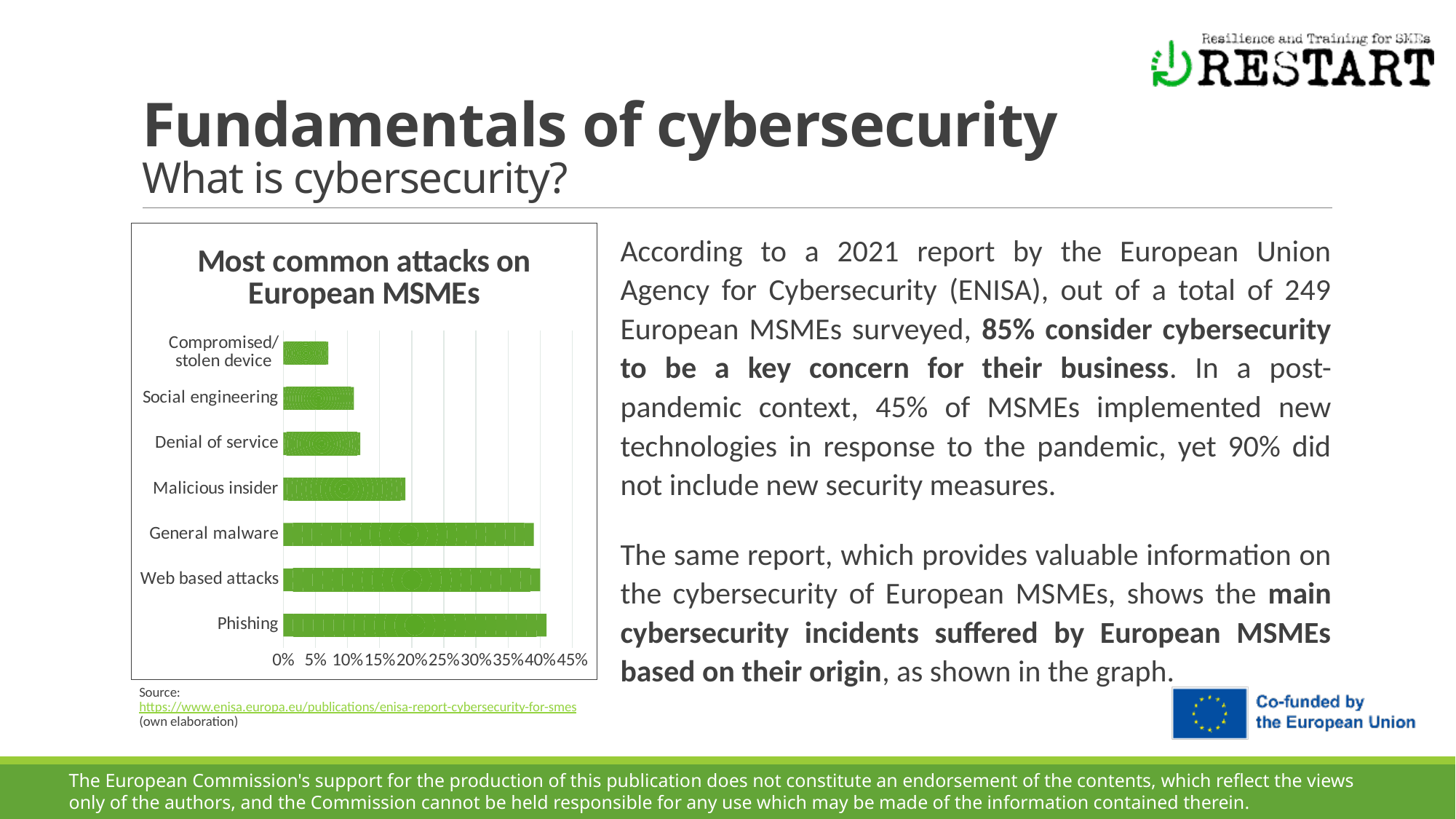
How many attack categories are shown in the chart? 7 Which attack category has the lowest value in the chart? Compromised/stolen device Is the value for Malicious insider greater or less than 15%? greater Is the value for Compromised/stolen device greater or less than 10%? less Which is larger, the value for Malicious insider or the value for Denial of service? Malicious insider What is the title of the chart? Most common attacks on European MSMEs What colour are the bars in the chart? green Which is larger, the value for General malware or the value for Social engineering? General malware Is the value for Phishing greater or less than 30%? greater What kind of chart is shown on the slide? bar chart